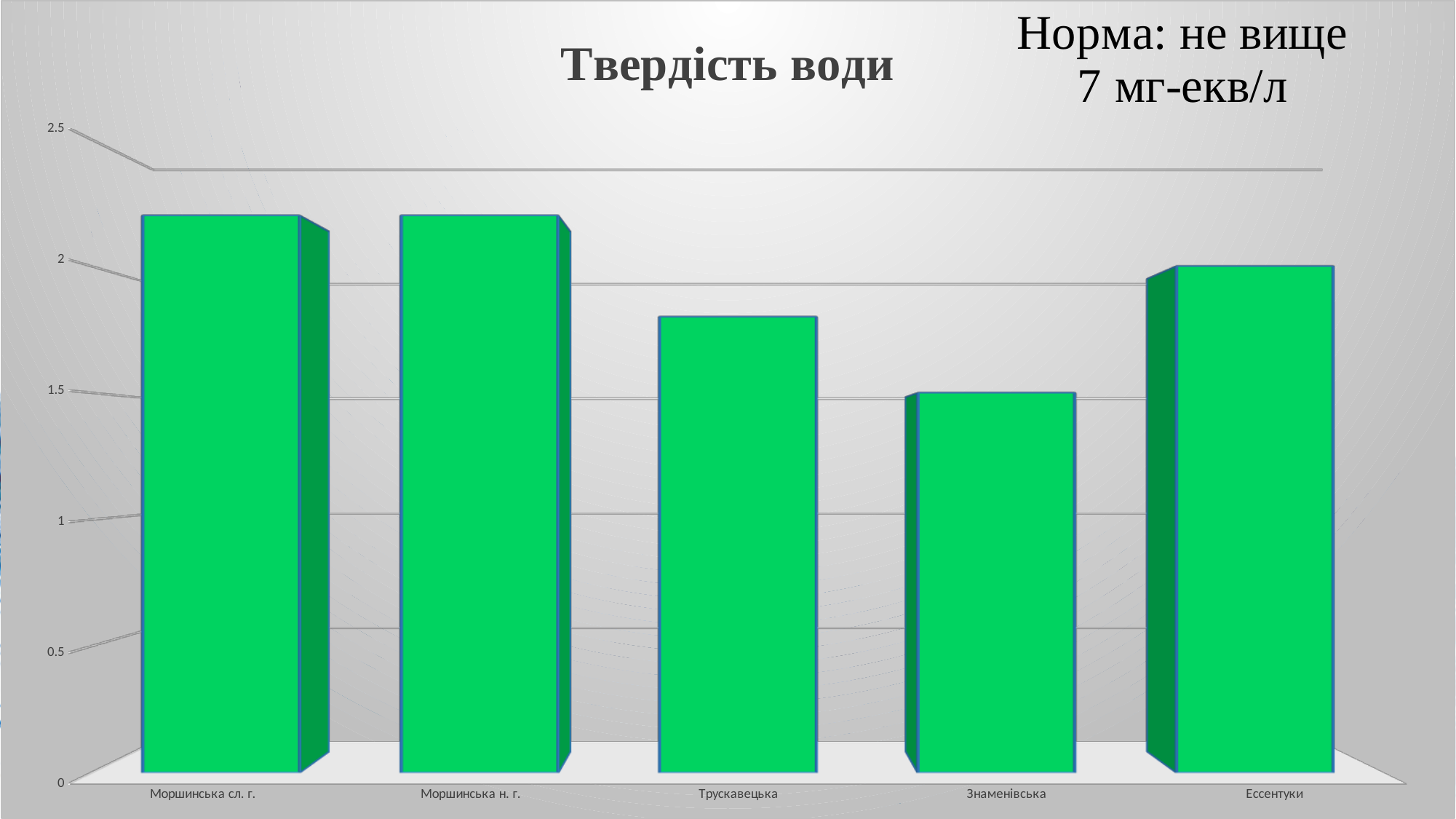
What is the title of the chart? Твердість води Is the value for Ессентуки greater or less than 1.5? greater Which is larger, the value for Трускавецька or the value for Знаменівська? Трускавецька What colour are the bars in the chart? green Which is larger, the value for Ессентуки or the value for Знаменівська? Ессентуки Which is larger, the value for Моршинська н. г. or the value for Трускавецька? Моршинська н. г. How many categories (water brands) are shown on the x axis? 5 Which category has the lowest value? Знаменівська Is the value for Знаменівська greater or less than 2? less Is the value for Трускавецька greater or less than 1.5? greater What kind of chart is shown on the slide? bar chart